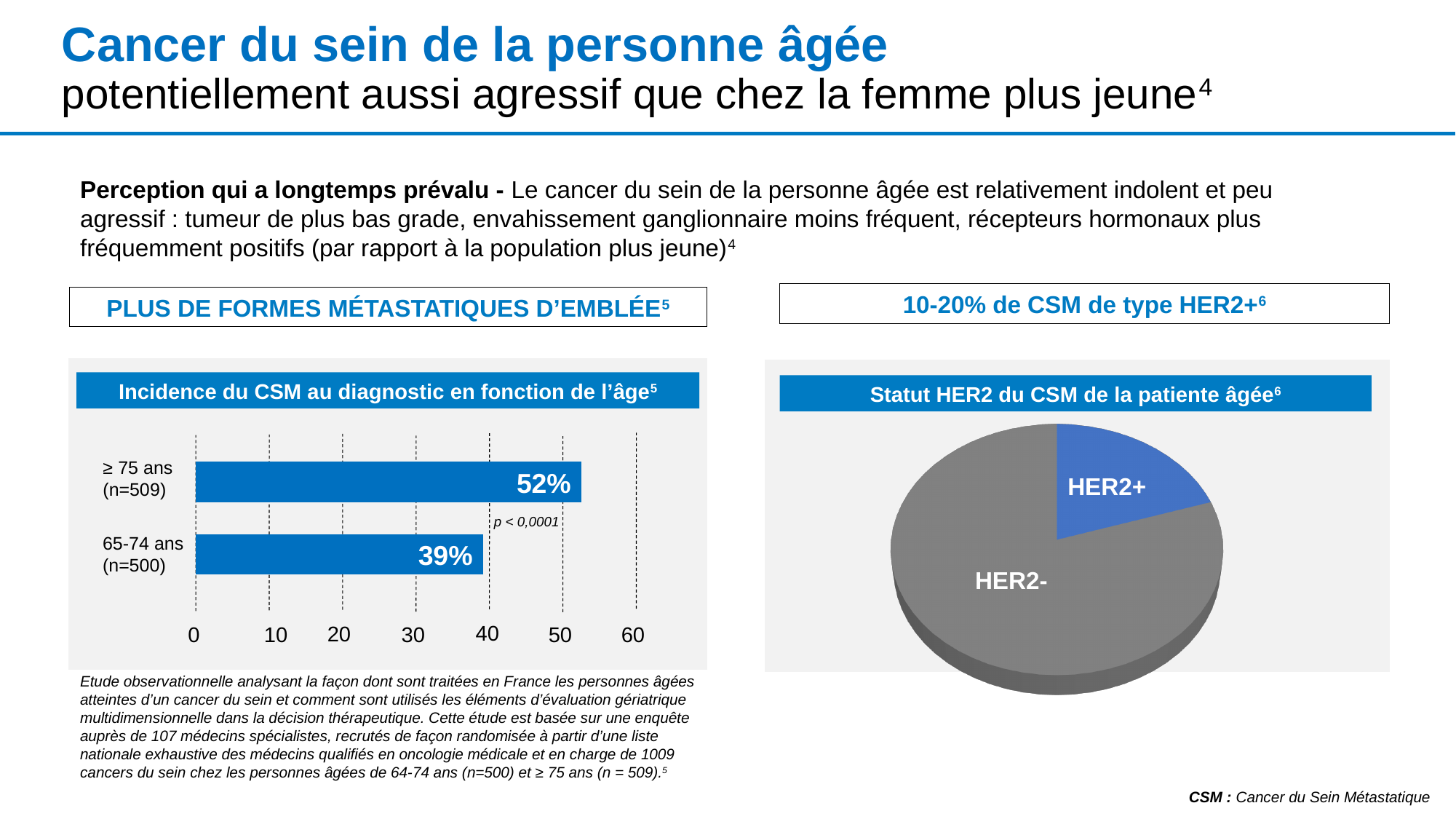
In the chart 'Incidence du CSM au diagnostic en fonction de l'âge', what is the value for 65-74 ans (n=500)? 39% In the chart 'Statut HER2 du CSM de la patiente âgée', which slice is larger, HER2+ or HER2-? HER2- In the chart 'Incidence du CSM au diagnostic en fonction de l'âge', which age group has the lowest value? 65-74 ans (n=500) In the chart 'Incidence du CSM au diagnostic en fonction de l'âge', what is the value for ≥ 75 ans (n=509)? 52% What kind of chart is 'Incidence du CSM au diagnostic en fonction de l'âge'? Bar chart How many slices does the pie chart 'Statut HER2 du CSM de la patiente âgée' have? 2 In the chart 'Incidence du CSM au diagnostic en fonction de l'âge', what is the difference between the values for ≥ 75 ans and 65-74 ans? 13% What kind of chart is 'Statut HER2 du CSM de la patiente âgée'? Pie chart How many age categories are shown in the chart 'Incidence du CSM au diagnostic en fonction de l'âge'? 2 In the chart 'Statut HER2 du CSM de la patiente âgée', what colour is the HER2+ slice? Blue In the chart 'Incidence du CSM au diagnostic en fonction de l'âge', is the value for 65-74 ans greater or less than 40? less In the chart 'Incidence du CSM au diagnostic en fonction de l'âge', which age group has the highest value? ≥ 75 ans (n=509)